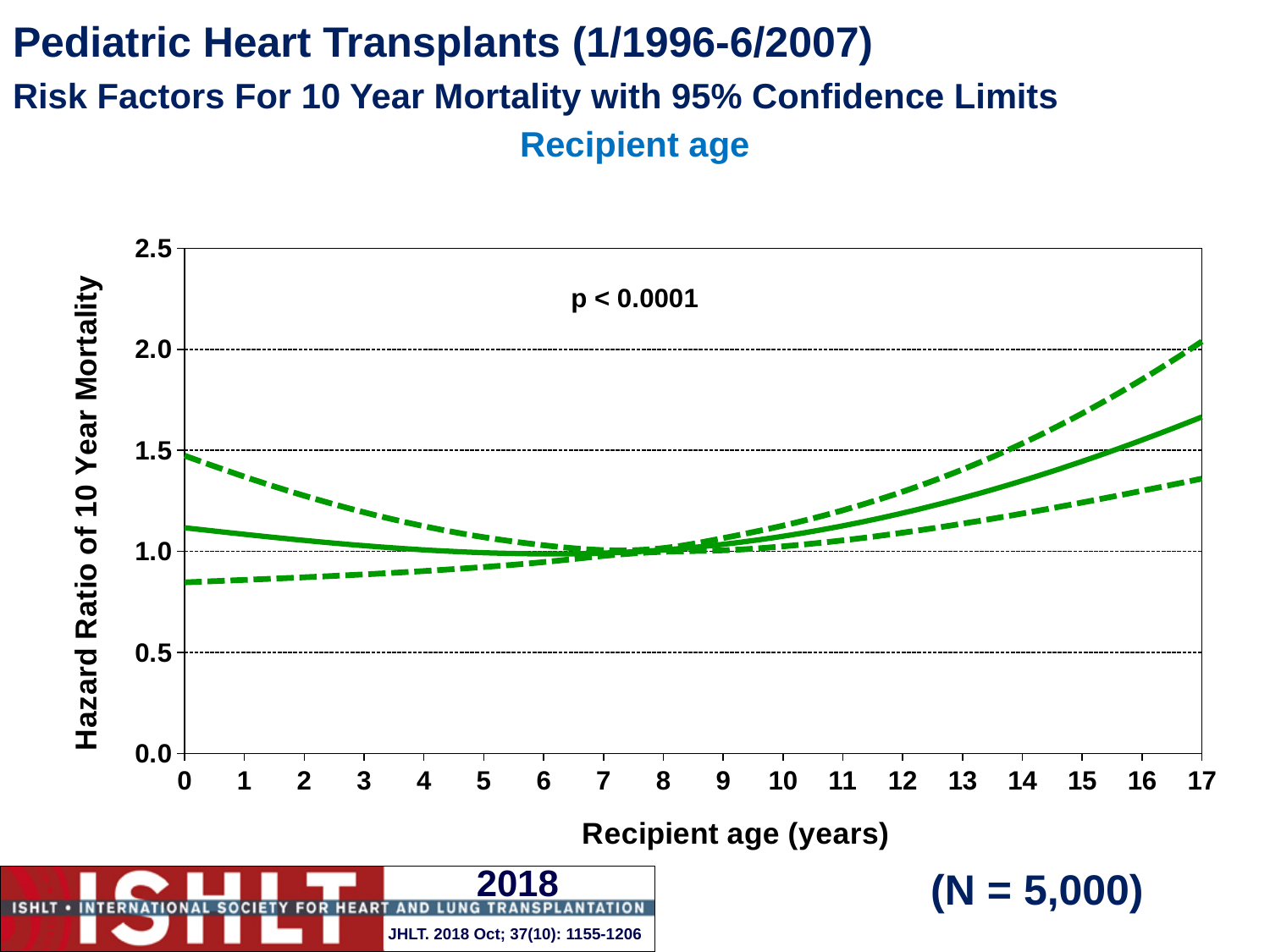
Does the solid hazard ratio line rise or fall as recipient age increases from 8 to 17 years? rises Is the solid line at recipient age 4 greater or less than 1.5? less Is the hazard ratio on the solid line at recipient age 0 greater or less than 1.0? greater What is the label of the y axis? Hazard Ratio of 10 Year Mortality What kind of chart is shown on the slide? line chart Is the lower dashed confidence limit at recipient age 0 greater or less than 1.0? less Which is larger on the solid line: the hazard ratio at recipient age 17 or at recipient age 0? recipient age 17 What p-value is printed on the chart? p < 0.0001 How many tick labels are shown on the x axis (Recipient age)? 18 How many lines are plotted on the chart? 3